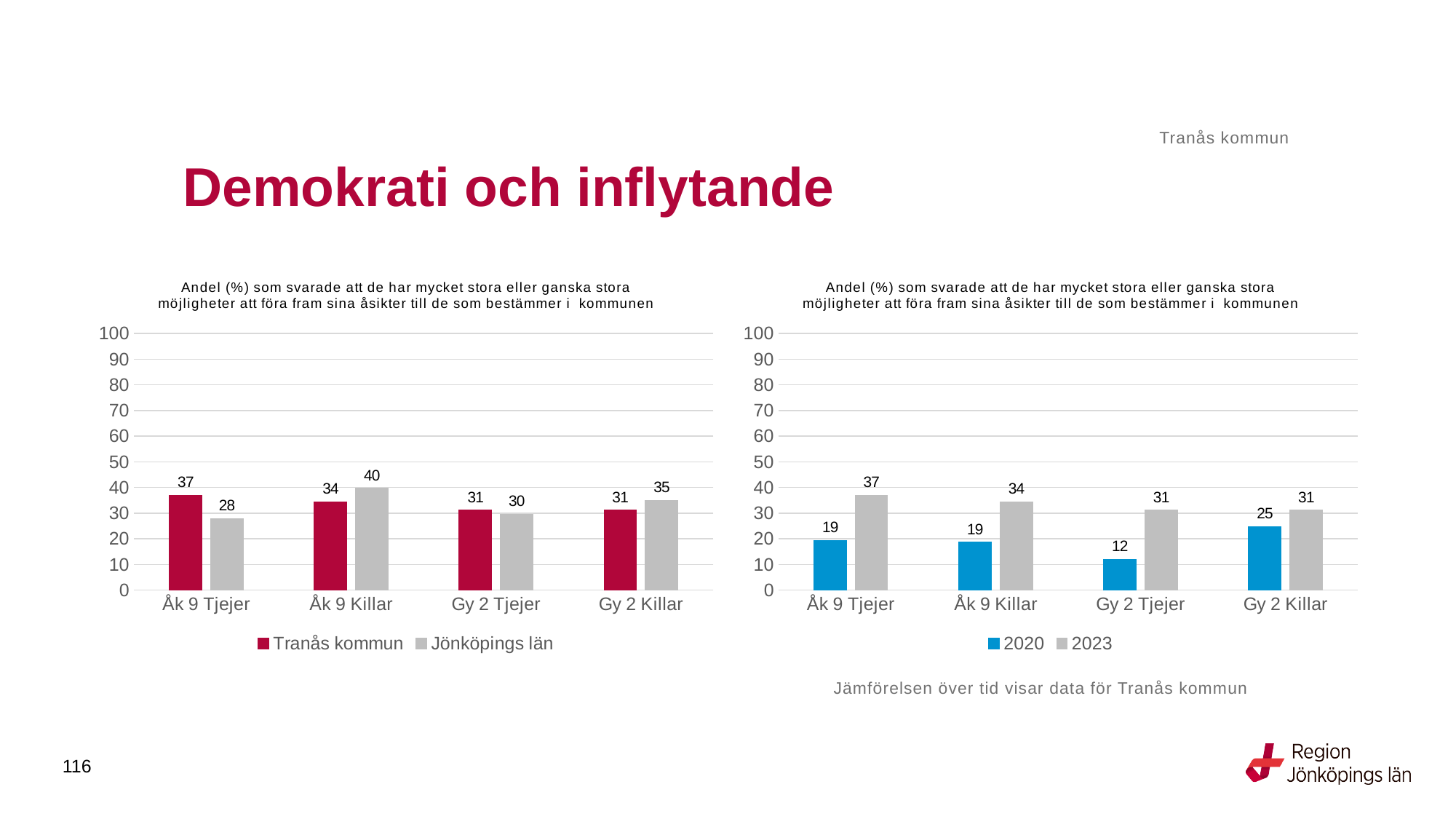
In the left chart, which category has the highest value for Jönköpings län? Åk 9 Killar What kind of chart is the right chart? Bar chart In the right chart, what is the difference between 2023 and 2020 for Gy 2 Tjejer? 19 In the right chart, how many series does the legend list? 2 In the left chart, what is the value for Jönköpings län for Gy 2 Killar? 35 How many categories are shown on the x axis of the left chart? 4 In the right chart, what is the value for 2020 for Gy 2 Tjejer? 12 In the right chart, what is the value for 2023 for Åk 9 Killar? 34 In the left chart, what is the value for Tranås kommun for Åk 9 Tjejer? 37 In the left chart, what is the difference between Tranås kommun and Jönköpings län for Åk 9 Tjejer? 9 In the right chart, which category has the lowest value for 2020? Gy 2 Tjejer In the left chart, which is larger for Åk 9 Killar: Tranås kommun or Jönköpings län? Jönköpings län